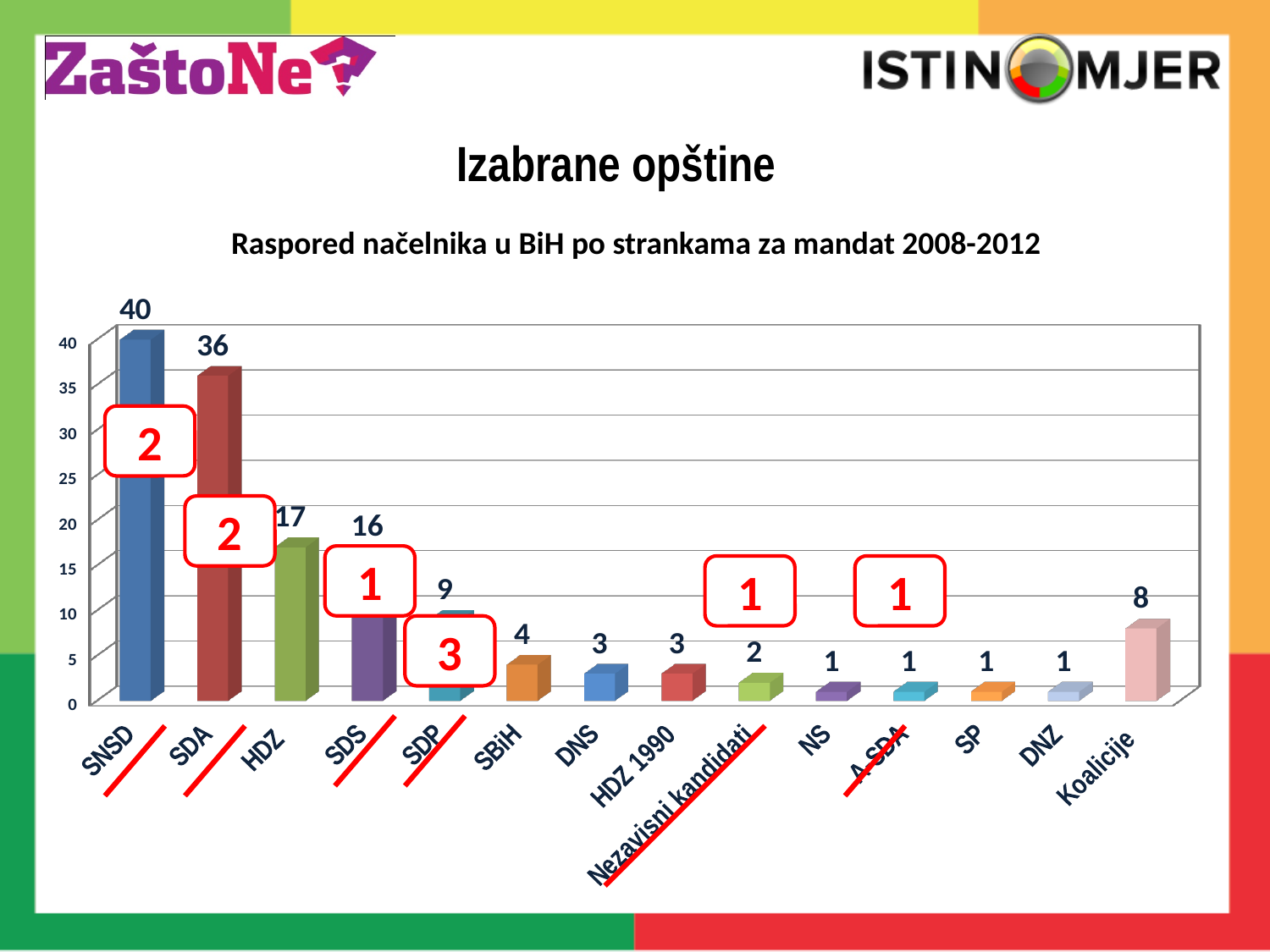
How many categories are shown on the x axis of the chart? 14 What is the difference between the values for HDZ and SDS? 1 What is the value for Koalicije? 8 Which is larger, the value for SBiH or the value for Koalicije? Koalicije What is the title of the chart? Raspored načelnika u BiH po strankama za mandat 2008-2012 What is the difference between the values for SNSD and SDA? 4 What type of chart is shown on the slide? bar chart Which party has the highest value in the chart? SNSD What is the value for SDA? 36 What is the value for SNSD? 40 What is the value for SDP? 9 Is the value for HDZ greater or less than 15? greater